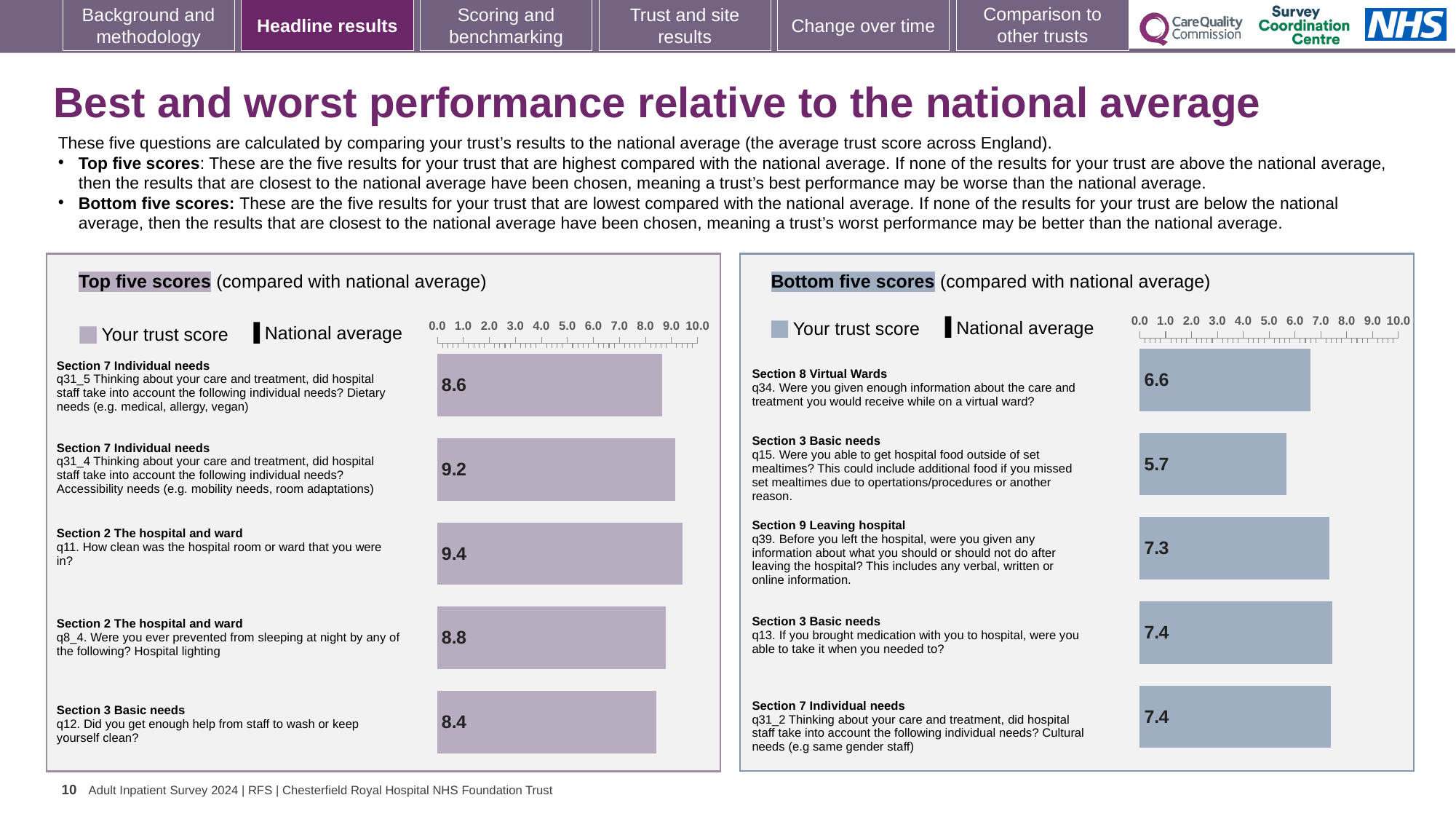
In the 'Top five scores' chart, what is the trust score for q11 (How clean was the hospital room or ward that you were in?)? 9.4 In the 'Bottom five scores' chart, what is the trust score for q15 (Were you able to get hospital food outside of set mealtimes?)? 5.7 In the 'Top five scores' chart, which question has the highest trust score? q11. How clean was the hospital room or ward that you were in? In the 'Bottom five scores' chart, which has the larger trust score: q34 (virtual ward information) or q39 (information before leaving hospital)? q39 What two entries does the legend of the 'Top five scores' chart list? Your trust score and National average How many bars are shown in the 'Top five scores' chart? 5 What kind of chart is the 'Bottom five scores' chart? Bar chart In the 'Bottom five scores' chart, which question has the lowest trust score? q15. Were you able to get hospital food outside of set mealtimes? In the 'Bottom five scores' chart, what is the difference between the score for q13 and the score for q34? 0.8 In the 'Top five scores' chart, what is the trust score for q8_4 (prevented from sleeping at night by hospital lighting)? 8.8 In the 'Top five scores' chart, what is the difference between the score for q11 (9.4) and the score for q12 (8.4)? 1.0 In the 'Top five scores' chart, is the trust score for q31_5 (dietary needs) greater or less than 8.0? greater